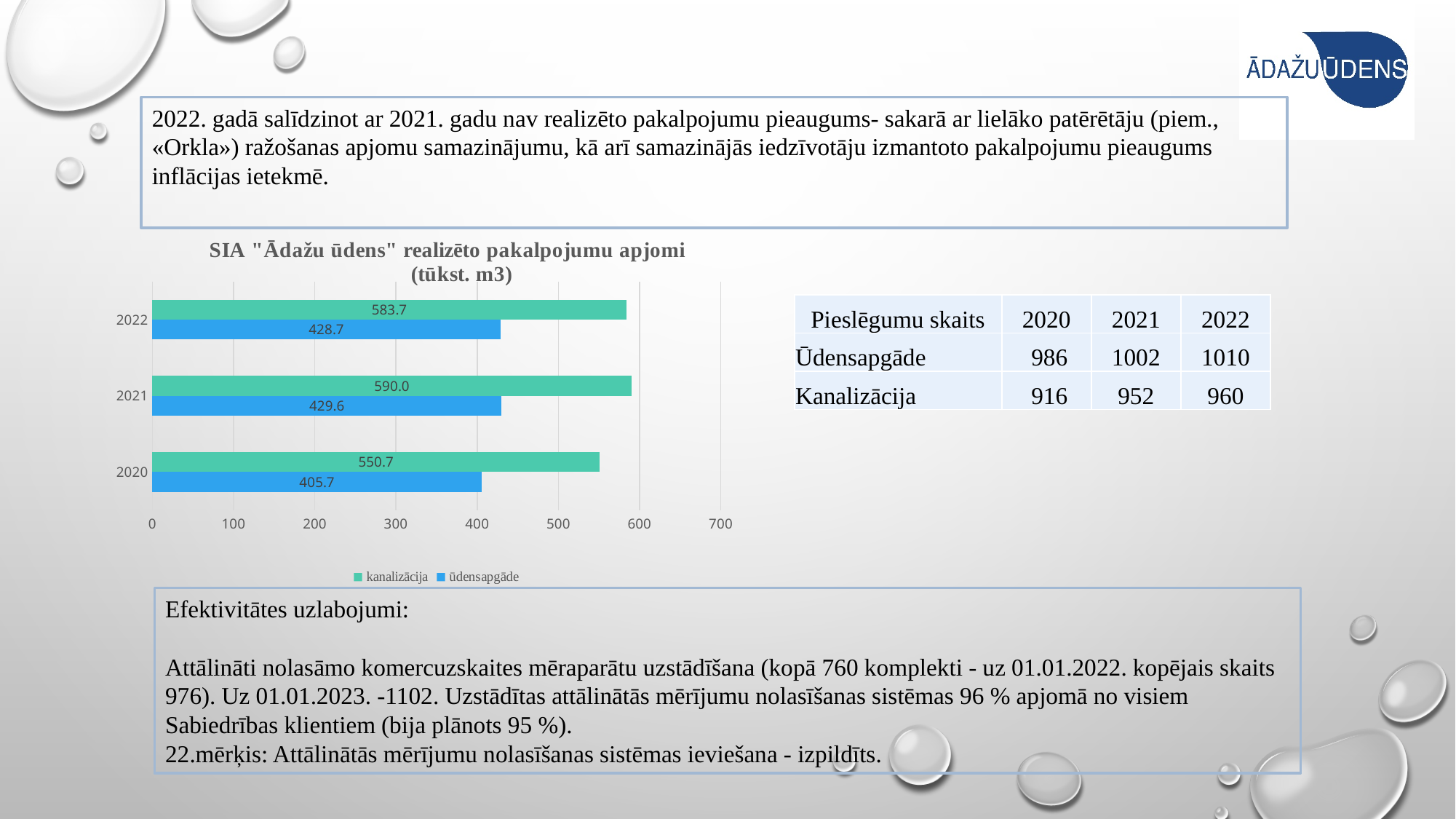
How many series does the legend list? 2 Is the kanalizācija value for 2020 greater or less than 500? greater What is the kanalizācija value for 2022? 583.7 Which is larger in 2020, the kanalizācija value or the ūdensapgāde value? kanalizācija How many years are shown on the chart? 3 What is the ūdensapgāde value for 2021? 429.6 What kind of chart is shown on the slide? bar chart What is the difference between the kanalizācija values for 2021 and 2020? 39.3 What is the difference between the kanalizācija and ūdensapgāde values for 2022? 155.0 Which year has the highest kanalizācija value? 2021 Which year has the lowest ūdensapgāde value? 2020 What is the ūdensapgāde value for 2020? 405.7